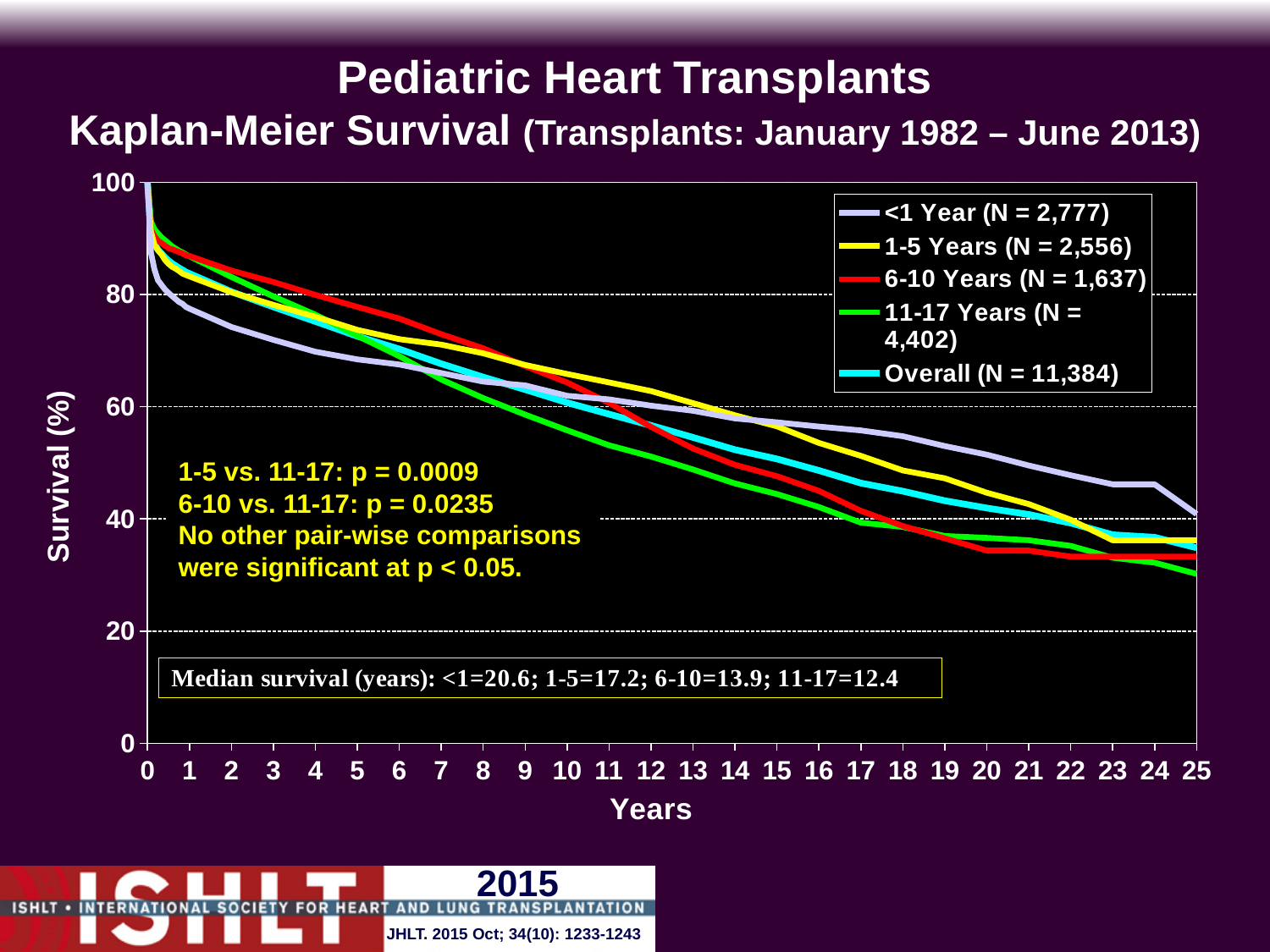
What is the N for the 6-10 Years group shown in the legend? 1,637 Which age group has the highest median survival? <1 Do the survival curves rise or fall as years increase along the x axis? fall Is the survival value for the 11-17 Years curve at 25 years greater or less than 40? less What is the median survival in years for the <1 age group? 20.6 How many series does the legend list? 5 What is the median survival in years for the 11-17 age group? 12.4 What kind of chart is shown on the slide? line chart At 25 years, which curve is higher: <1 Year or 11-17 Years? <1 Year What is the difference in median survival (years) between the <1 group and the 11-17 group? 8.2 What is the N for the Overall series shown in the legend? 11,384